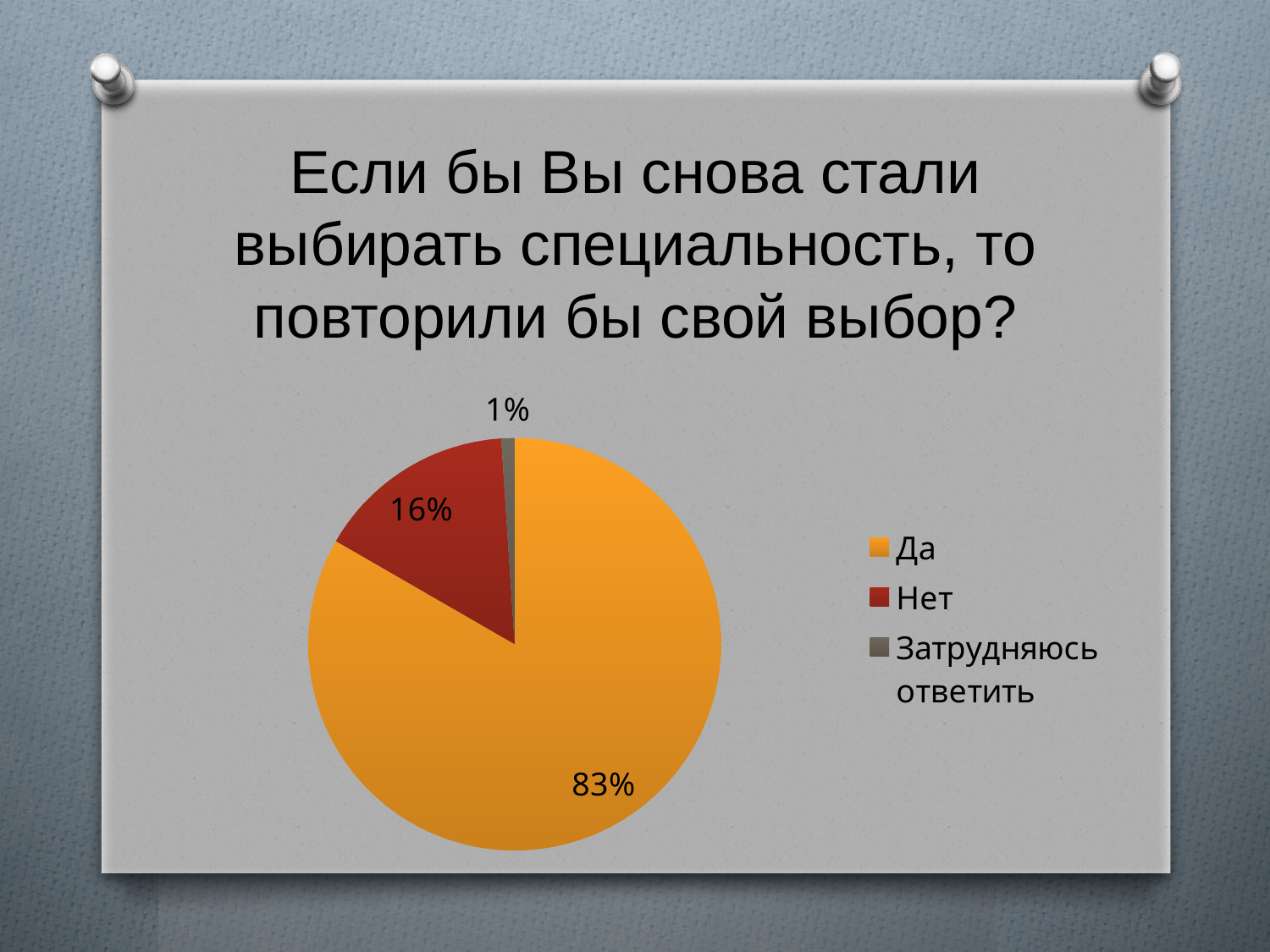
How many categories does the pie chart have? 3 What colour is the slice for "Нет"? red What is the value shown for "Нет"? 16% What is the difference between the values for "Да" and "Нет"? 67% How many entries does the legend list? 3 Which category has the smallest slice of the pie? Затрудняюсь ответить What is the value shown for "Затрудняюсь ответить"? 1% What kind of chart is shown on the slide? pie chart What share of the pie does "Да" take? 83% Which category has the largest slice of the pie? Да What is the difference between the values for "Нет" and "Затрудняюсь ответить"? 15% Which is larger, the value for "Нет" or the value for "Затрудняюсь ответить"? Нет